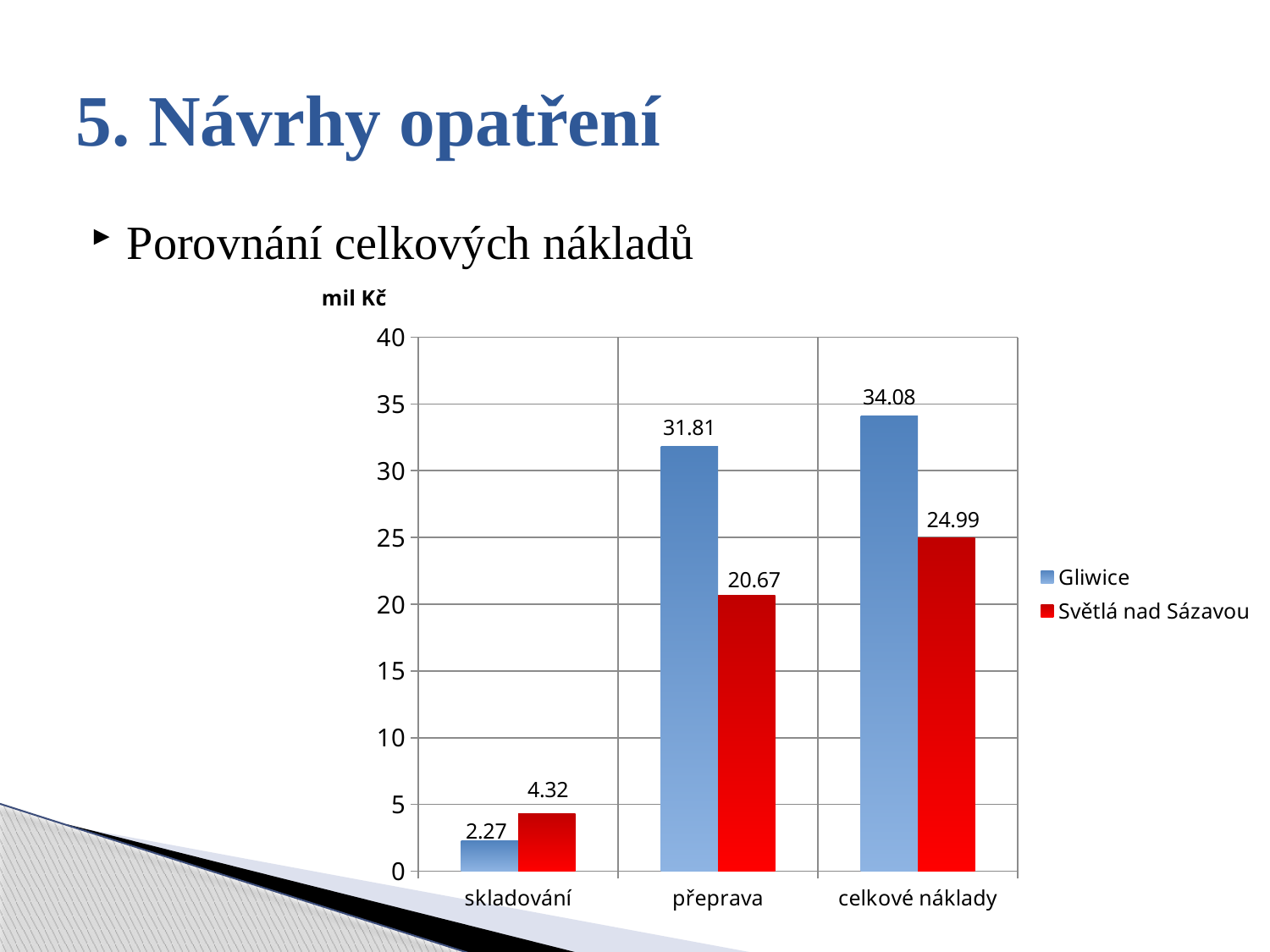
What is the value for Světlá nad Sázavou in the přeprava category? 20.67 How many categories are shown on the x axis? 3 What is the value for Světlá nad Sázavou in the skladování category? 4.32 What kind of chart is shown on the slide? bar chart Which category has the highest value for Gliwice? celkové náklady Which category has the lowest value for Světlá nad Sázavou? skladování What is the value for Gliwice in the celkové náklady category? 34.08 What is the value for Gliwice in the skladování category? 2.27 What unit is shown above the vertical axis of the chart? mil Kč What is the difference between Gliwice and Světlá nad Sázavou in the celkové náklady category? 9.09 How many series does the legend list? 2 In the přeprava category, which series has the larger value, Gliwice or Světlá nad Sázavou? Gliwice